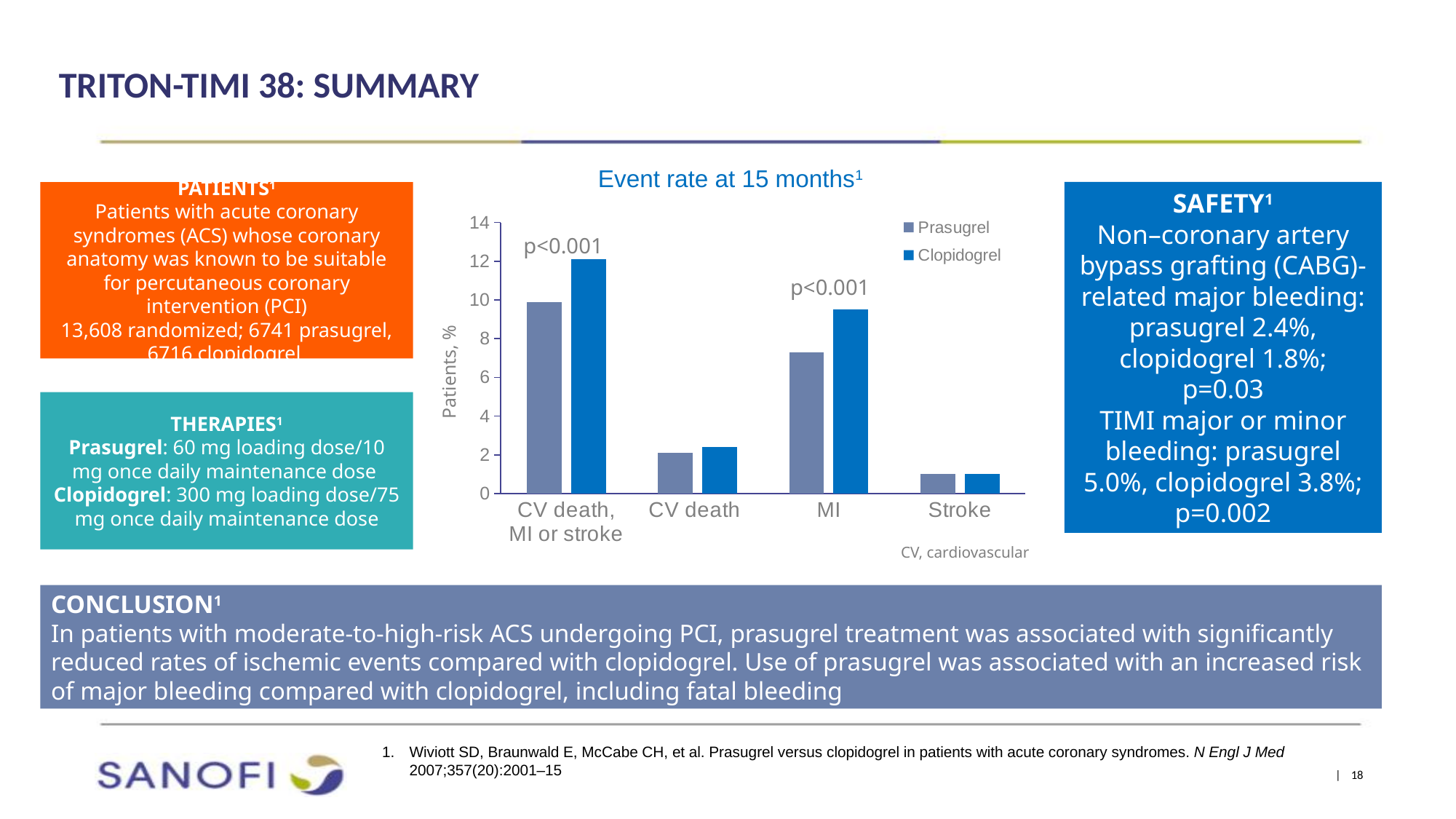
Which category has the lowest Prasugrel value in the 'Event rate at 15 months' chart? Stroke Which category has the highest Clopidogrel value in the 'Event rate at 15 months' chart? CV death, MI or stroke In the 'Event rate at 15 months' chart, is the Prasugrel value for MI greater or less than 8? less How many series does the legend of the 'Event rate at 15 months' chart list? 2 What kind of chart is shown under the title 'Event rate at 15 months'? bar chart What p-value is printed above the 'CV death, MI or stroke' bars in the 'Event rate at 15 months' chart? p<0.001 In the 'Event rate at 15 months' chart, which is larger for MI: the Prasugrel value or the Clopidogrel value? Clopidogrel How many categories are shown on the x axis of the 'Event rate at 15 months' chart? 4 In the 'Event rate at 15 months' chart, is the Clopidogrel value for MI greater or less than 8? greater What is the y-axis label of the 'Event rate at 15 months' chart? Patients, %